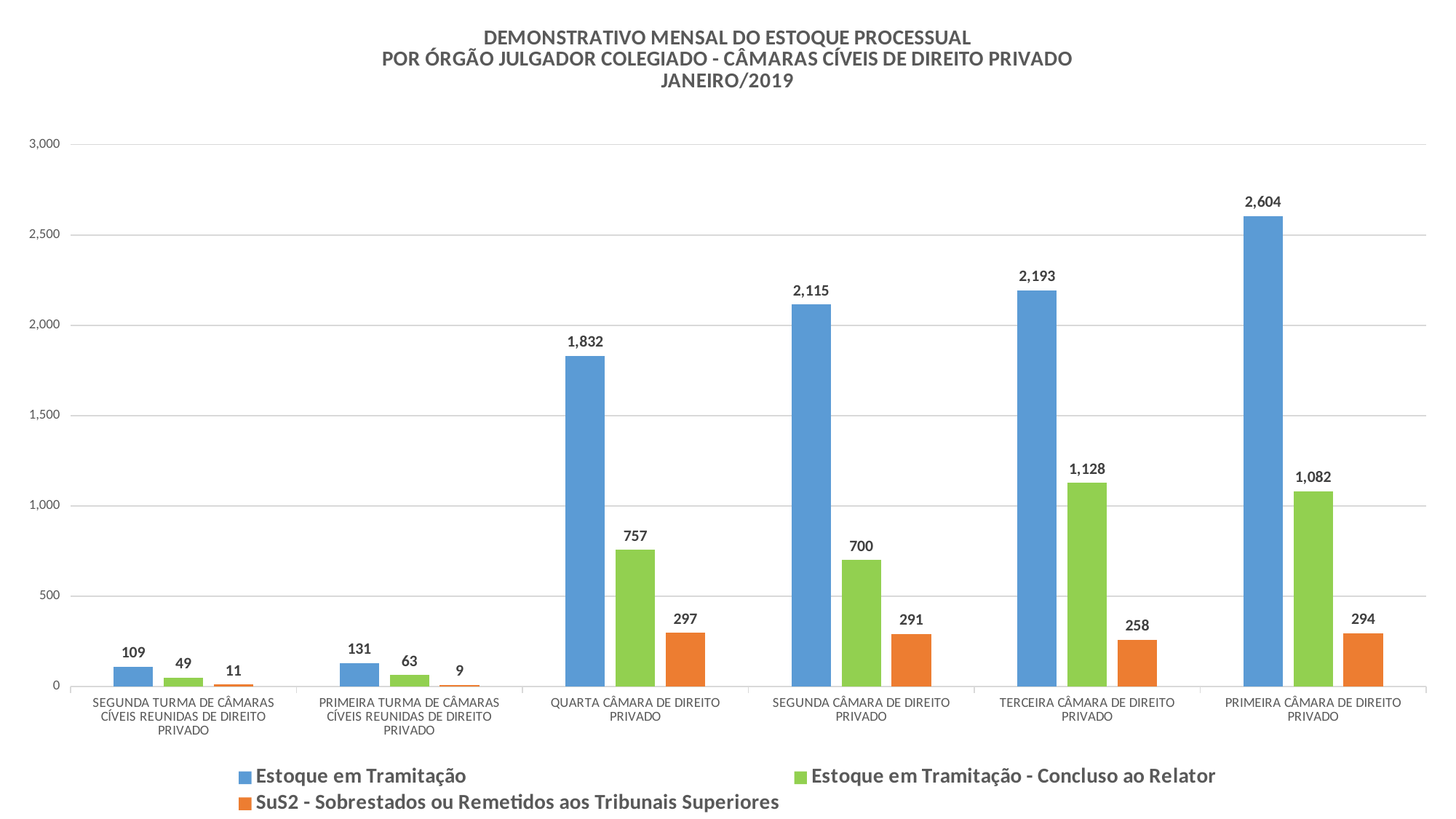
Is the Estoque em Tramitação value for SEGUNDA CÂMARA DE DIREITO PRIVADO greater or less than 2,000? greater Which is larger: the Estoque em Tramitação - Concluso ao Relator value for QUARTA CÂMARA DE DIREITO PRIVADO or for SEGUNDA CÂMARA DE DIREITO PRIVADO? QUARTA CÂMARA DE DIREITO PRIVADO What is the value of SuS2 - Sobrestados ou Remetidos aos Tribunais Superiores for QUARTA CÂMARA DE DIREITO PRIVADO? 297 How many series does the legend list? 3 Which category has the lowest value for SuS2 - Sobrestados ou Remetidos aos Tribunais Superiores? PRIMEIRA TURMA DE CÂMARAS CÍVEIS REUNIDAS DE DIREITO PRIVADO How many categories are shown on the x axis? 6 What kind of chart is shown on the slide? bar chart What is the value of Estoque em Tramitação - Concluso ao Relator for TERCEIRA CÂMARA DE DIREITO PRIVADO? 1,128 What colour are the bars for SuS2 - Sobrestados ou Remetidos aos Tribunais Superiores? orange What is the value of Estoque em Tramitação for PRIMEIRA CÂMARA DE DIREITO PRIVADO? 2,604 What is the difference between the Estoque em Tramitação values for PRIMEIRA CÂMARA DE DIREITO PRIVADO and TERCEIRA CÂMARA DE DIREITO PRIVADO? 411 Which category has the highest value for Estoque em Tramitação? PRIMEIRA CÂMARA DE DIREITO PRIVADO